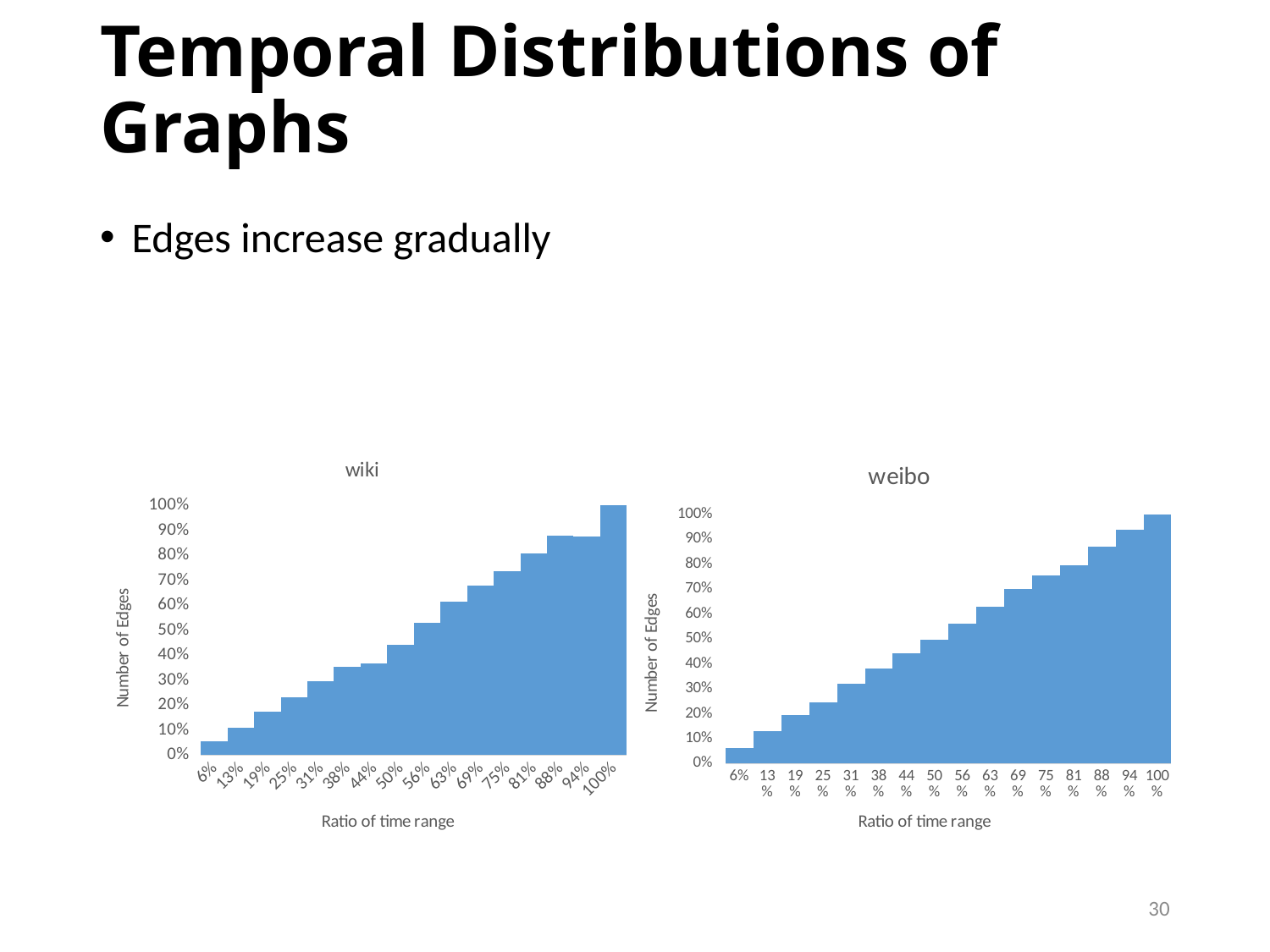
In the wiki chart, do the values rise or fall as the ratio of time range increases? rise How many categories are shown on the x axis of the weibo chart? 16 What kind of chart is the wiki chart? bar chart In the wiki chart, which is larger, the value for 25% or the value for 75%? 75% What is the label on the y axis of the weibo chart? Number of Edges In the wiki chart, is the value for 6% greater or less than 10%? less In the weibo chart, what is the value for the 100% ratio of time range? 100% In the wiki chart, is the value for 50% greater or less than 40%? greater In the wiki chart, which ratio of time range has the highest number of edges? 100% In the weibo chart, is the value for 88% greater or less than 80%? greater In the weibo chart, which ratio of time range has the lowest number of edges? 6%